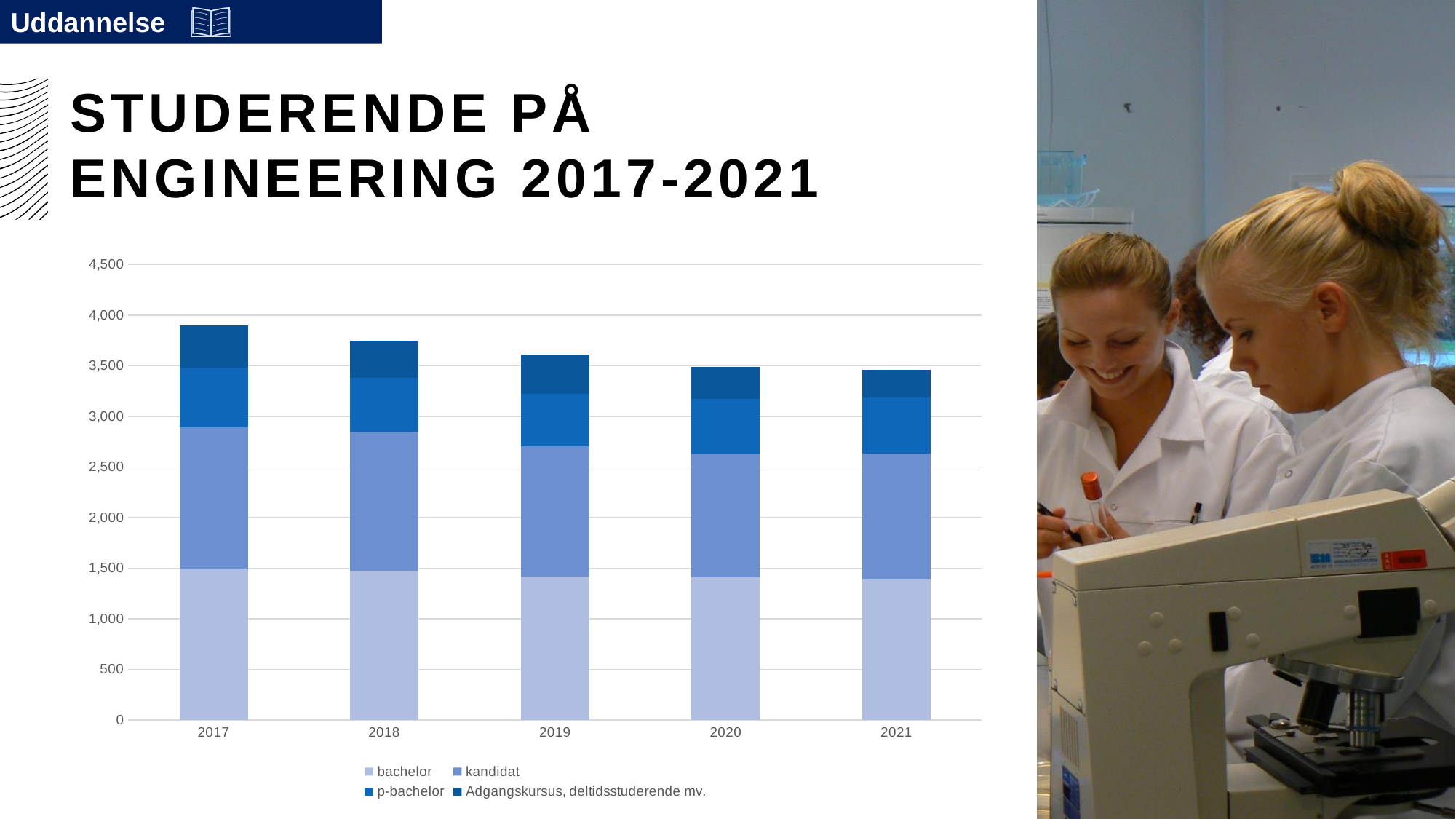
Is the total bar for 2021 greater or less than 3,000? greater How many series does the chart's legend list? 4 Do the total bar heights rise or fall from 2017 to 2021? Fall Is the total bar for 2017 greater or less than 3,500? greater Is the total bar for 2019 greater or less than 4,000? less What kind of chart is shown on the slide? Stacked bar chart What is the title of the slide containing the chart? STUDERENDE PÅ ENGINEERING 2017-2021 Which series is listed last in the chart's legend? Adgangskursus, deltidsstuderende mv. Which year has the highest total number of students in the chart? 2017 How many years are shown on the x axis of the chart? 5 Which is larger, the total bar for 2017 or the total bar for 2021? 2017